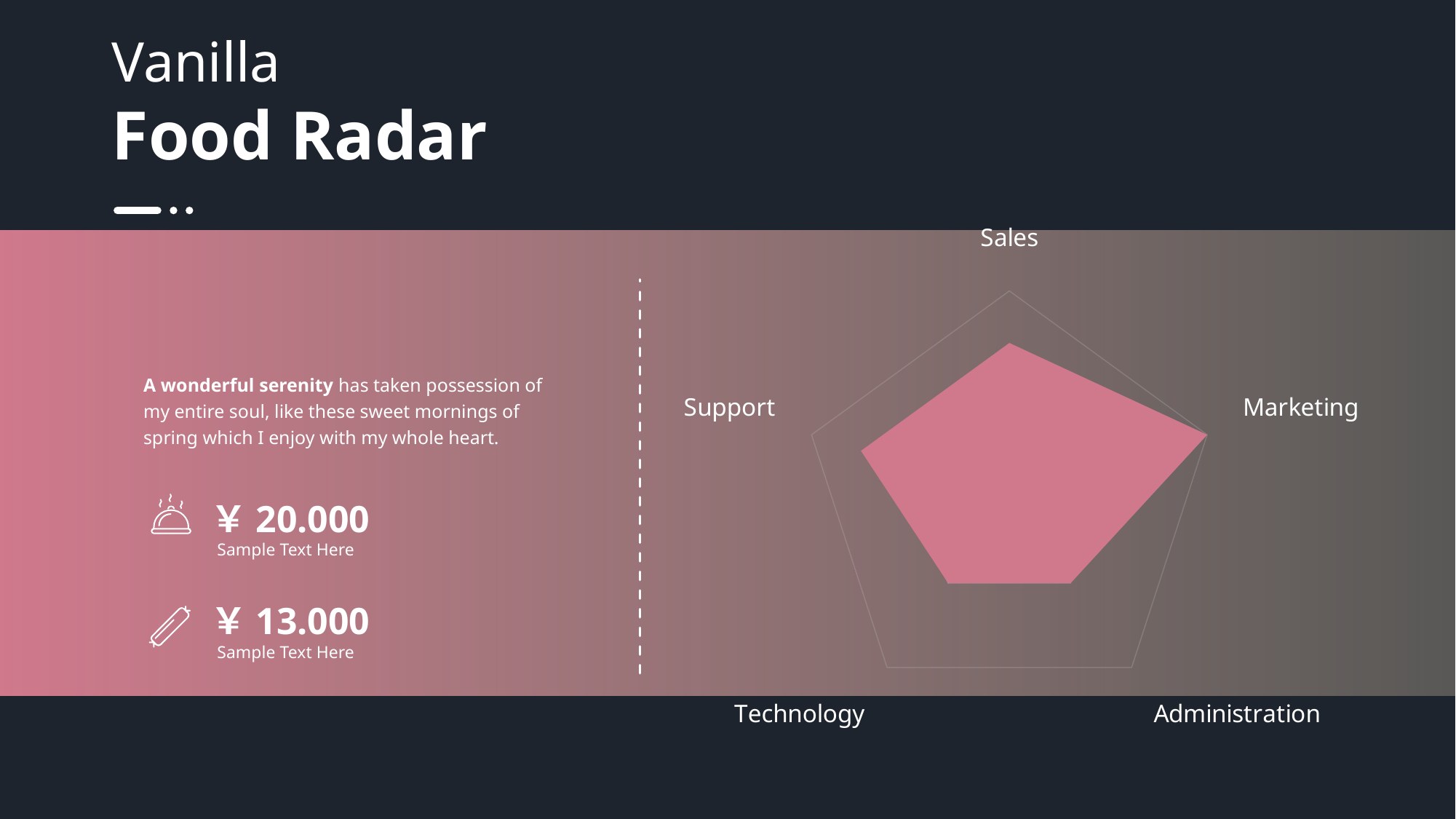
How many categories (axes) does the radar chart have? 5 Which is larger on the radar chart, the value for Support or the value for Administration? Support Which category has the highest value on the radar chart? Marketing Which category label appears at the top of the radar chart? Sales Which is larger on the radar chart, the value for Marketing or the value for Sales? Marketing Which is larger on the radar chart, the value for Marketing or the value for Administration? Marketing What kind of chart is shown on the slide? radar chart What colour is the filled data area of the radar chart? pink